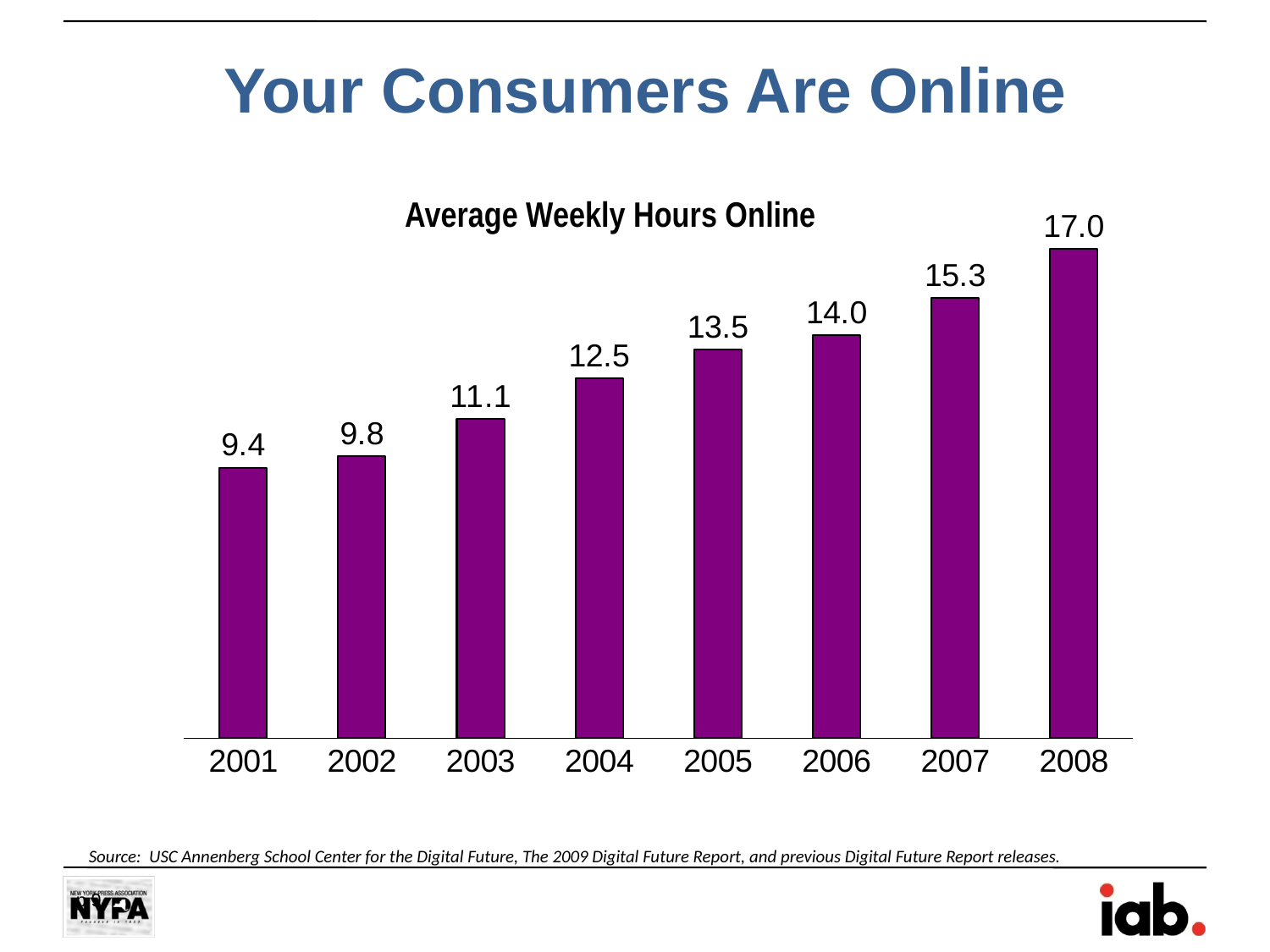
What is the average weekly hours online for 2005? 13.5 Do the values rise or fall from 2001 to 2008? Rise What is the difference in average weekly hours online between 2008 and 2001? 7.6 What is the average weekly hours online for 2001? 9.4 What is the average weekly hours online for 2008? 17.0 What is the difference in average weekly hours online between 2007 and 2006? 1.3 What is the title of the chart? Average Weekly Hours Online Which year has the lowest average weekly hours online? 2001 Which year has the highest average weekly hours online? 2008 How many years are shown on the chart? 8 What kind of chart is shown on the slide? Bar chart Which year has a larger value, 2004 or 2006? 2006